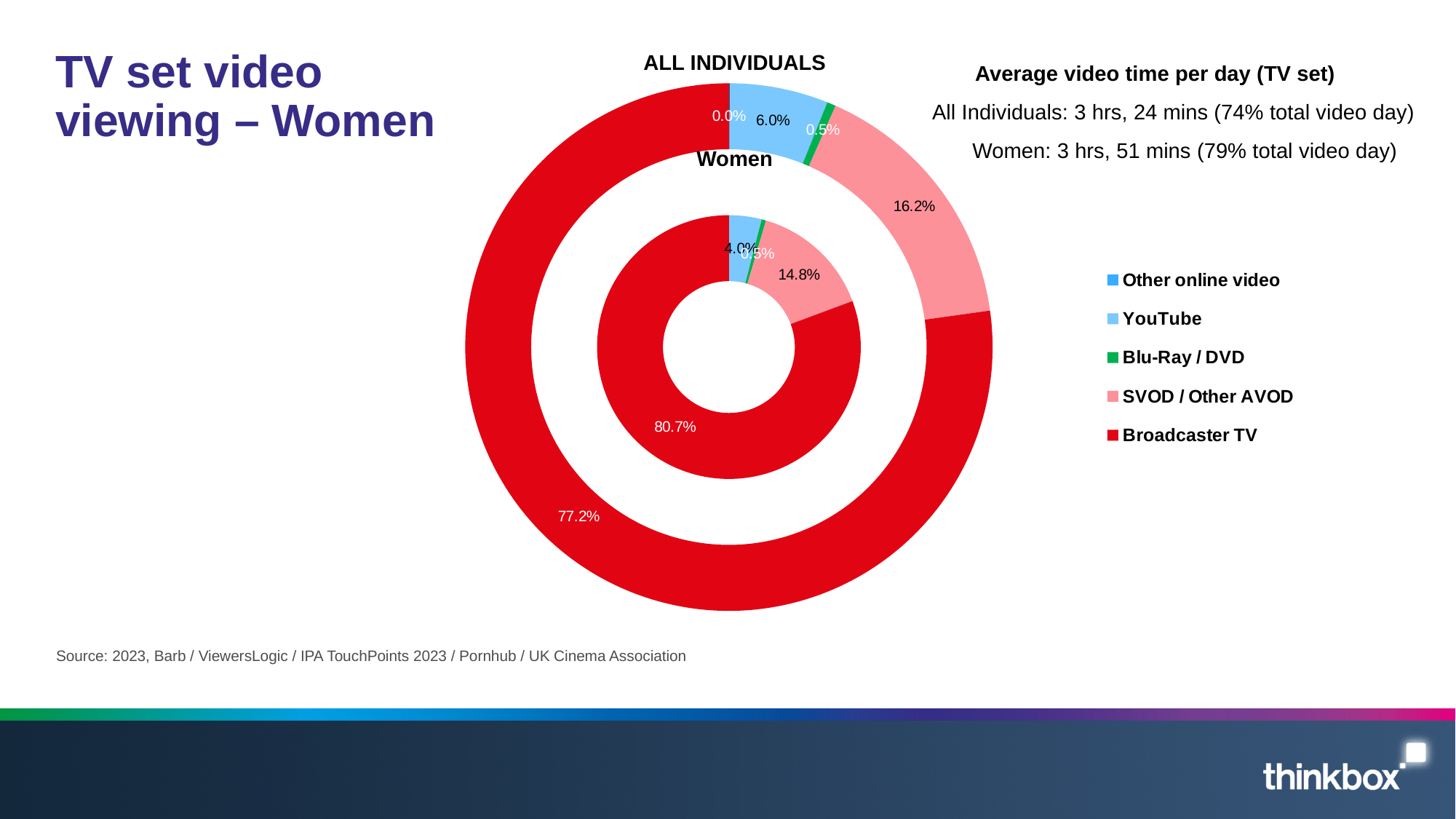
What share of TV set video viewing does Broadcaster TV account for in the Women ring? 80.7% What is the SVOD / Other AVOD share in the Women ring? 14.8% What is the SVOD / Other AVOD share in the ALL INDIVIDUALS ring? 16.2% What share of TV set video viewing does Broadcaster TV account for in the ALL INDIVIDUALS ring? 77.2% Which category has the smallest share in the ALL INDIVIDUALS ring? Other online video How much larger is the Broadcaster TV share for Women than for ALL INDIVIDUALS? 3.5 percentage points What type of chart is shown on the slide? Doughnut (pie) chart Which category has the largest share in the Women ring? Broadcaster TV What is the YouTube share in the Women ring? 4.0% What is the YouTube share in the ALL INDIVIDUALS ring? 6.0% How many categories does the legend list? 5 Is the YouTube share larger for ALL INDIVIDUALS or for Women? ALL INDIVIDUALS